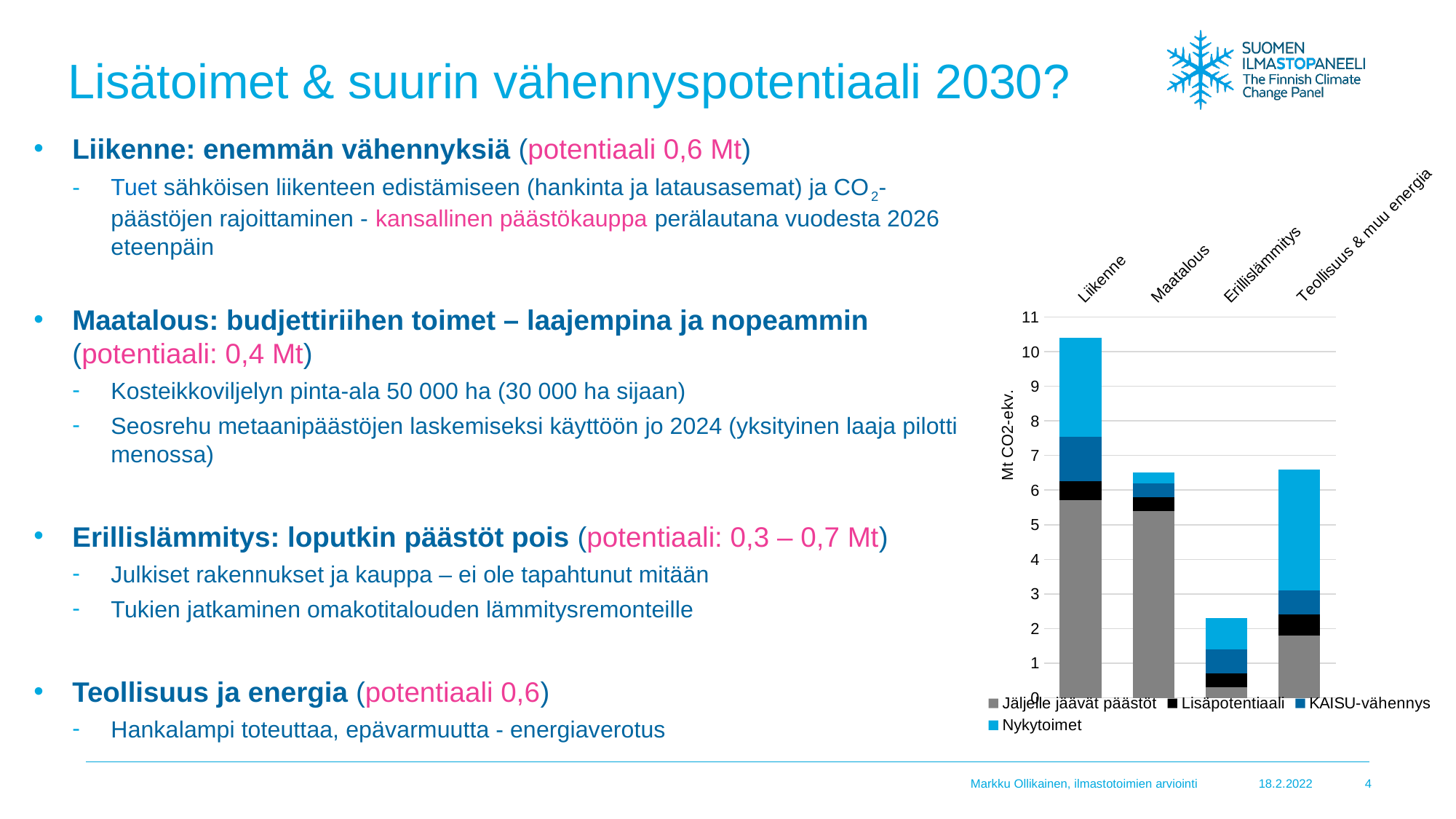
Is the total stacked bar for Erillislämmitys greater or less than 3? less Is the Jäljelle jäävät päästöt segment for Liikenne greater or less than 5? greater Which has the larger total stacked bar, Liikenne or Maatalous? Liikenne Which category has the tallest stacked bar in the chart? Liikenne Which category has the shortest stacked bar in the chart? Erillislämmitys What kind of chart is shown on the slide? Stacked bar chart Which has the larger total stacked bar, Erillislämmitys or Teollisuus & muu energia? Teollisuus & muu energia Is the total stacked bar for Maatalous greater or less than 6? greater How many series does the chart's legend list? 4 How many categories are shown on the x axis of the chart? 4 What is the label on the chart's vertical axis? Mt CO2-ekv.